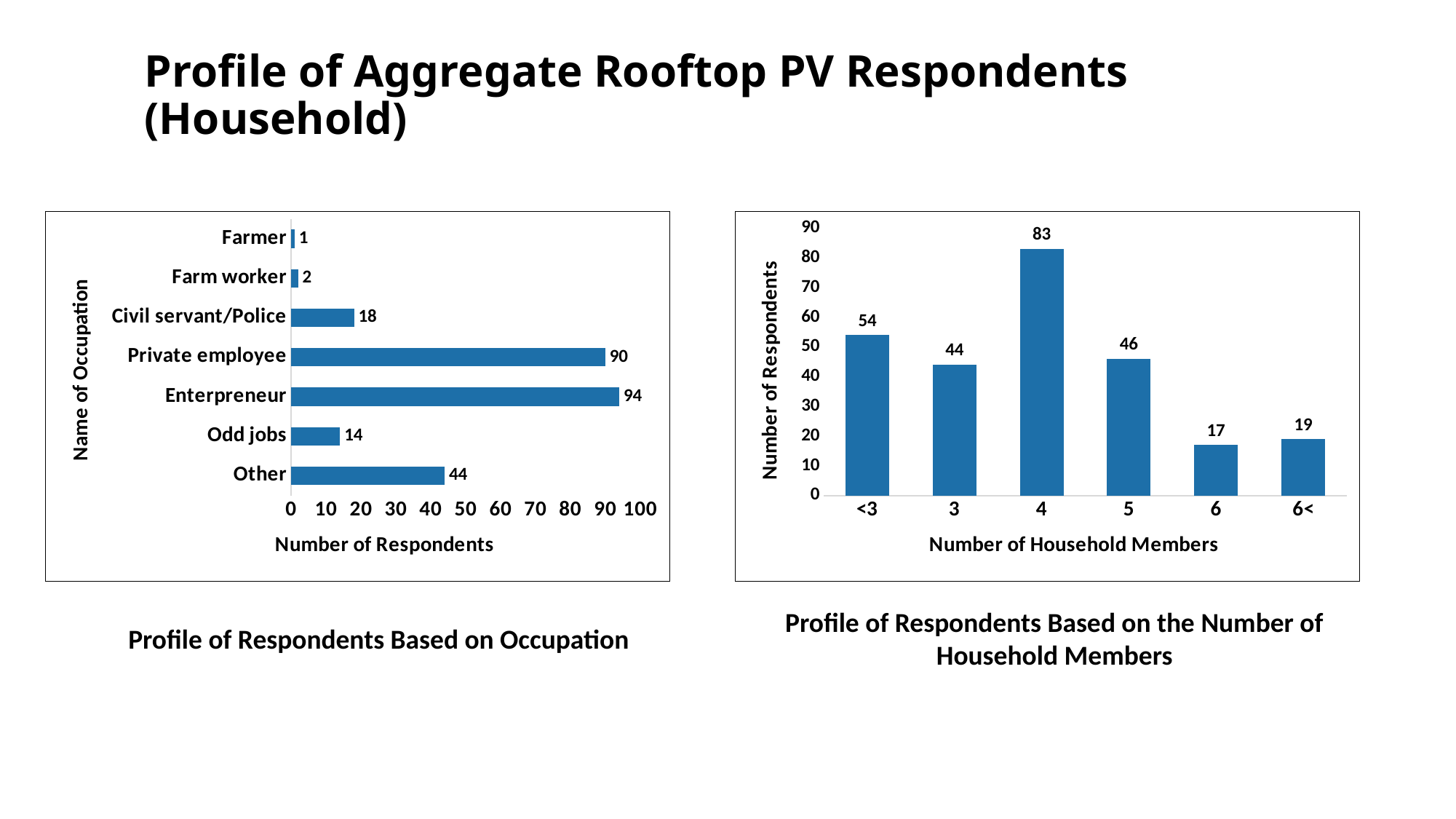
In the 'Profile of Respondents Based on the Number of Household Members' chart, how many categories are shown on the x axis? 6 In the 'Profile of Respondents Based on Occupation' chart, which occupation has the lowest number of respondents? Farmer In the 'Profile of Respondents Based on Occupation' chart, which occupation has the highest number of respondents? Enterpreneur What kind of chart is the 'Profile of Respondents Based on Occupation' chart? Bar chart In the 'Profile of Respondents Based on the Number of Household Members' chart, which category has the lowest number of respondents? 6 In the 'Profile of Respondents Based on the Number of Household Members' chart, how many respondents have 4 household members? 83 In the 'Profile of Respondents Based on Occupation' chart, what is the difference between the number of respondents for Other and Odd jobs? 30 In the 'Profile of Respondents Based on Occupation' chart, how many occupation categories are shown? 7 In the 'Profile of Respondents Based on the Number of Household Members' chart, what is the difference between the number of respondents for 4 and 3 household members? 39 In the 'Profile of Respondents Based on Occupation' chart, how many respondents are Private employees? 90 In the 'Profile of Respondents Based on the Number of Household Members' chart, which has more respondents: <3 or 5? <3 What is the x-axis label of the 'Profile of Respondents Based on the Number of Household Members' chart? Number of Household Members